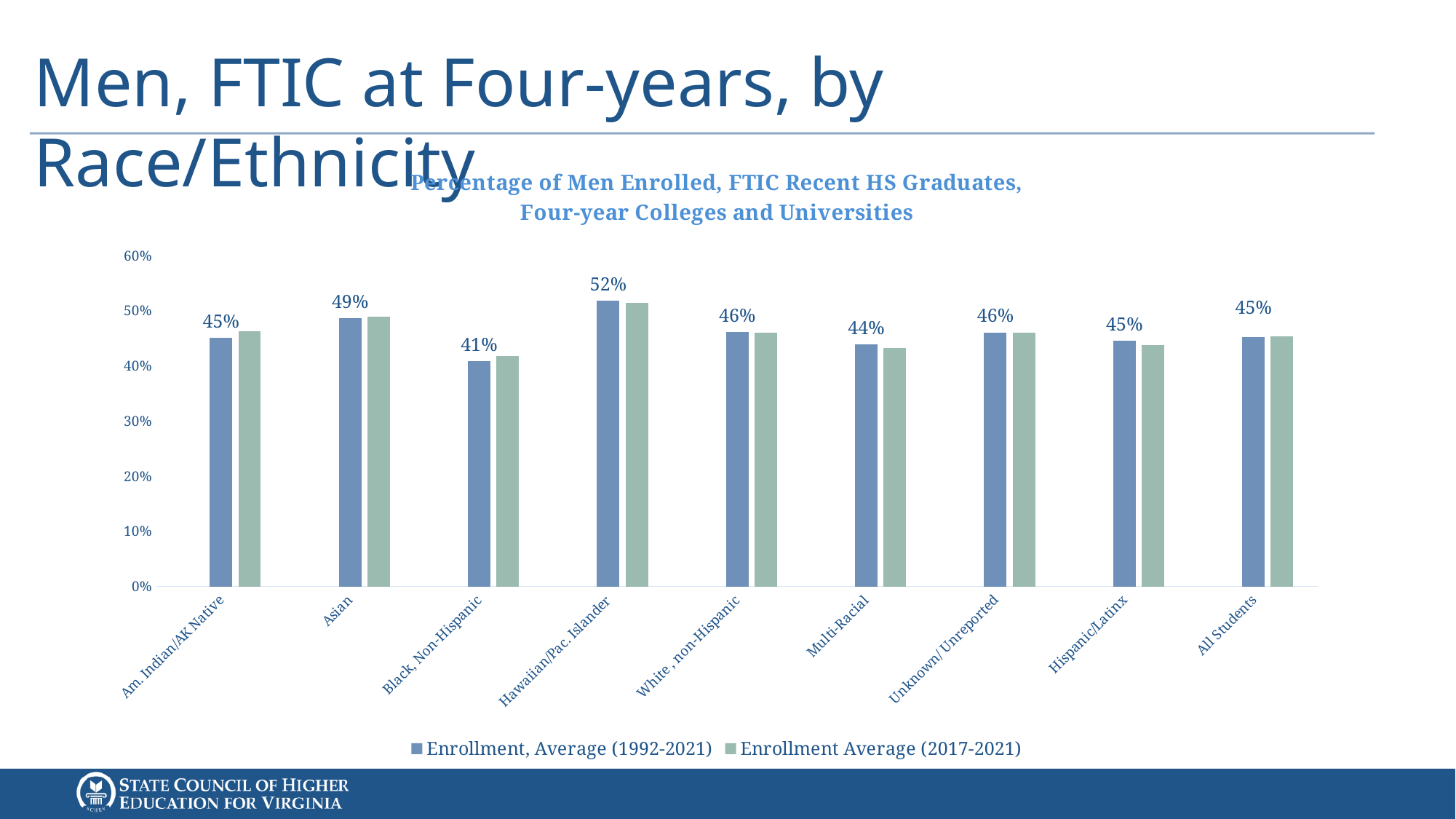
What type of chart is shown on the slide? bar chart What is the title of the chart? Percentage of Men Enrolled, FTIC Recent HS Graduates, Four-year Colleges and Universities Which has the larger Enrollment, Average (1992-2021) value, Asian or Multi-Racial? Asian Which category has the lowest Enrollment, Average (1992-2021) value? Black, Non-Hispanic What is the Enrollment, Average (1992-2021) value for Asian? 49% How many race/ethnicity categories are shown on the x axis? 9 What is the difference between the Enrollment, Average (1992-2021) values for Hawaiian/Pac. Islander and Black, Non-Hispanic? 11% What is the Enrollment, Average (1992-2021) value for Black, Non-Hispanic? 41% How many series does the legend list? 2 Which category has the highest Enrollment, Average (1992-2021) value? Hawaiian/Pac. Islander Is the Enrollment Average (2017-2021) value for Black, Non-Hispanic greater or less than 50%? less What is the Enrollment, Average (1992-2021) value for Hawaiian/Pac. Islander? 52%